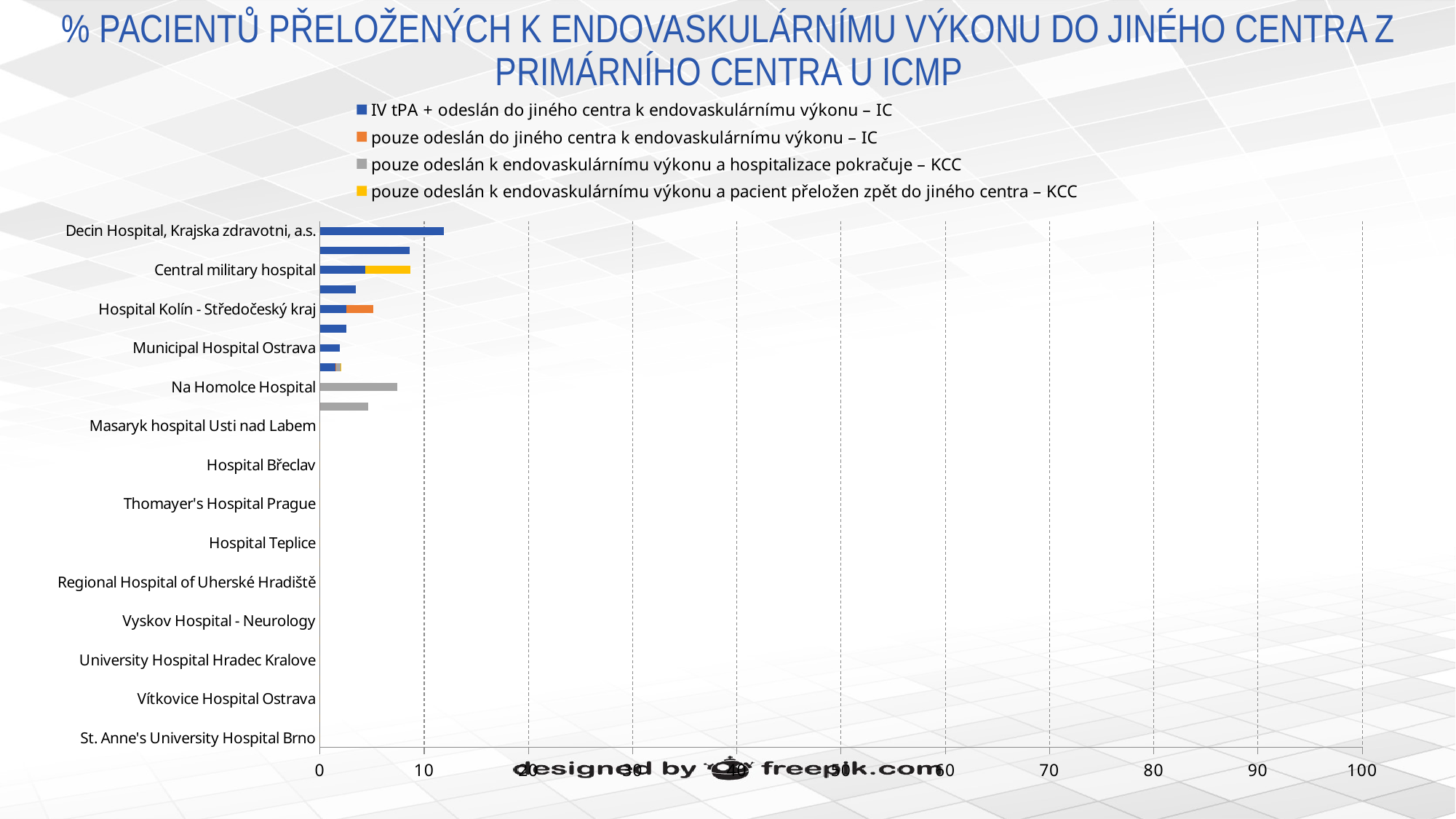
Which labelled hospital has the longest bar? Decin Hospital, Krajska zdravotni, a.s. Which legend series is shown in orange? pouze odeslán do jiného centra k endovaskulárnímu výkonu – IC How many series does the legend list? 4 What kind of chart is shown on the slide? bar chart Which has the longer bar, Decin Hospital, Krajska zdravotni, a.s. or Na Homolce Hospital? Decin Hospital, Krajska zdravotni, a.s. Is the total bar for Hospital Kolín - Středočeský kraj greater or less than 10? less Is the value for Na Homolce Hospital greater or less than 10? less What is the highest value shown on the horizontal axis? 100 Is the total bar for Central military hospital greater or less than 10? less Which has the longer bar, Decin Hospital, Krajska zdravotni, a.s. or Central military hospital? Decin Hospital, Krajska zdravotni, a.s.